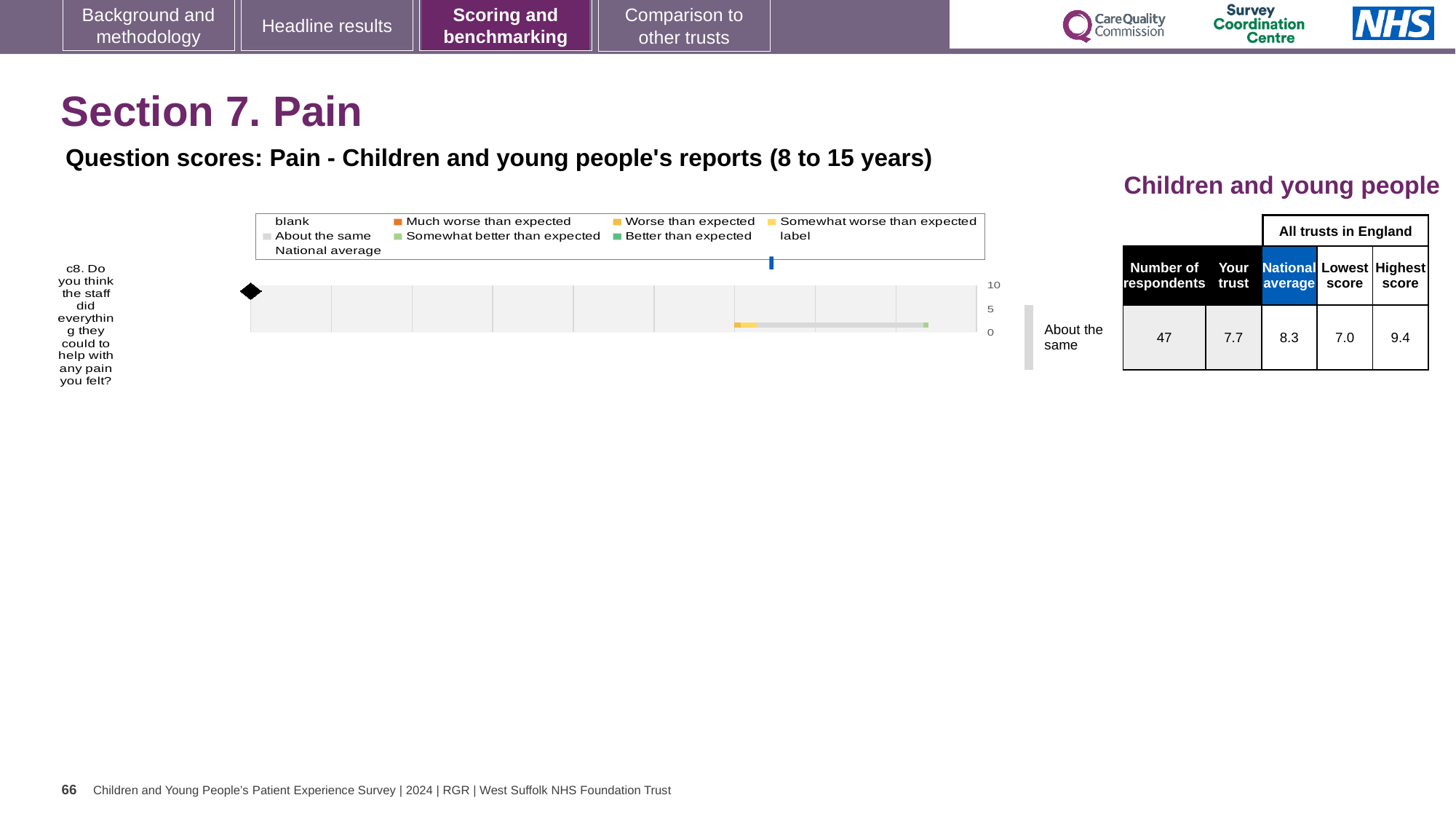
How many entries does the chart legend list? 9 How many question categories are plotted on the chart? 1 According to the table beside the chart, what is the highest score among all trusts in England for question c8? 9.4 Which is larger for question c8: the 'Your trust' score or the national average score? National average According to the table beside the chart, what is the 'Your trust' score for question c8? 7.7 According to the table beside the chart, what is the lowest score among all trusts in England for question c8? 7.0 What kind of chart is shown on the slide? bar chart According to the table beside the chart, how many respondents answered question c8? 47 According to the table beside the chart, what is the national average score for question c8? 8.3 Which legend entry is shown in blue on the chart? National average What is the highest tick value shown on the chart's value axis? 10 What is the difference between the highest score (9.4) and the lowest score (7.0) shown in the table for question c8? 2.4